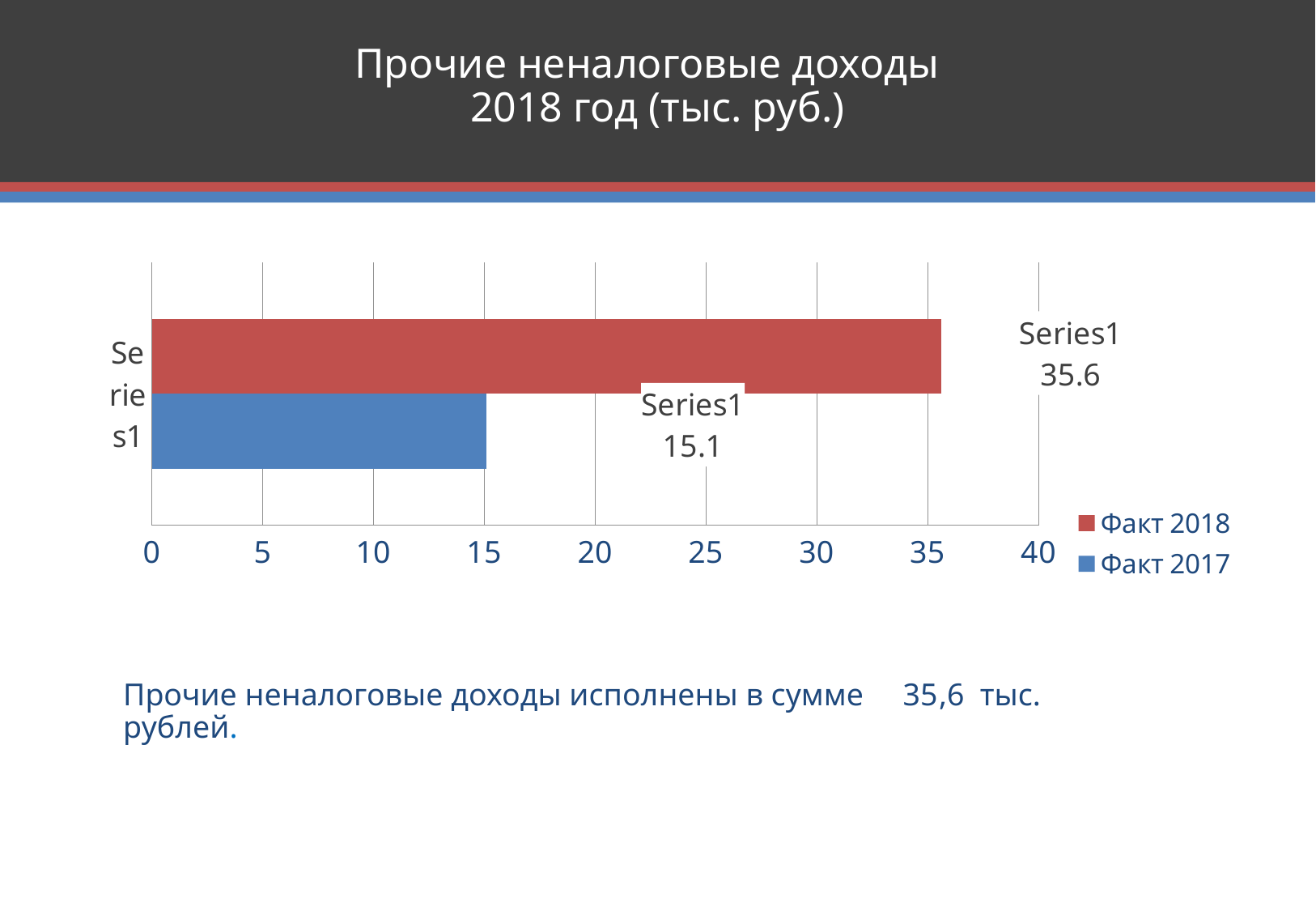
What is the difference between the Факт 2018 and Факт 2017 values? 20.5 Which series has the lowest value? Факт 2017 What kind of chart is shown on the slide? bar chart What is the value for Факт 2018? 35.6 Is the value for Факт 2018 greater or less than 30? greater Is the value for Факт 2017 greater or less than 20? less What is the maximum value shown on the horizontal axis? 40 Which series has the higher value, Факт 2018 or Факт 2017? Факт 2018 What colour is the bar for Факт 2017? blue What is the value for Факт 2017? 15.1 How many series does the legend list? 2